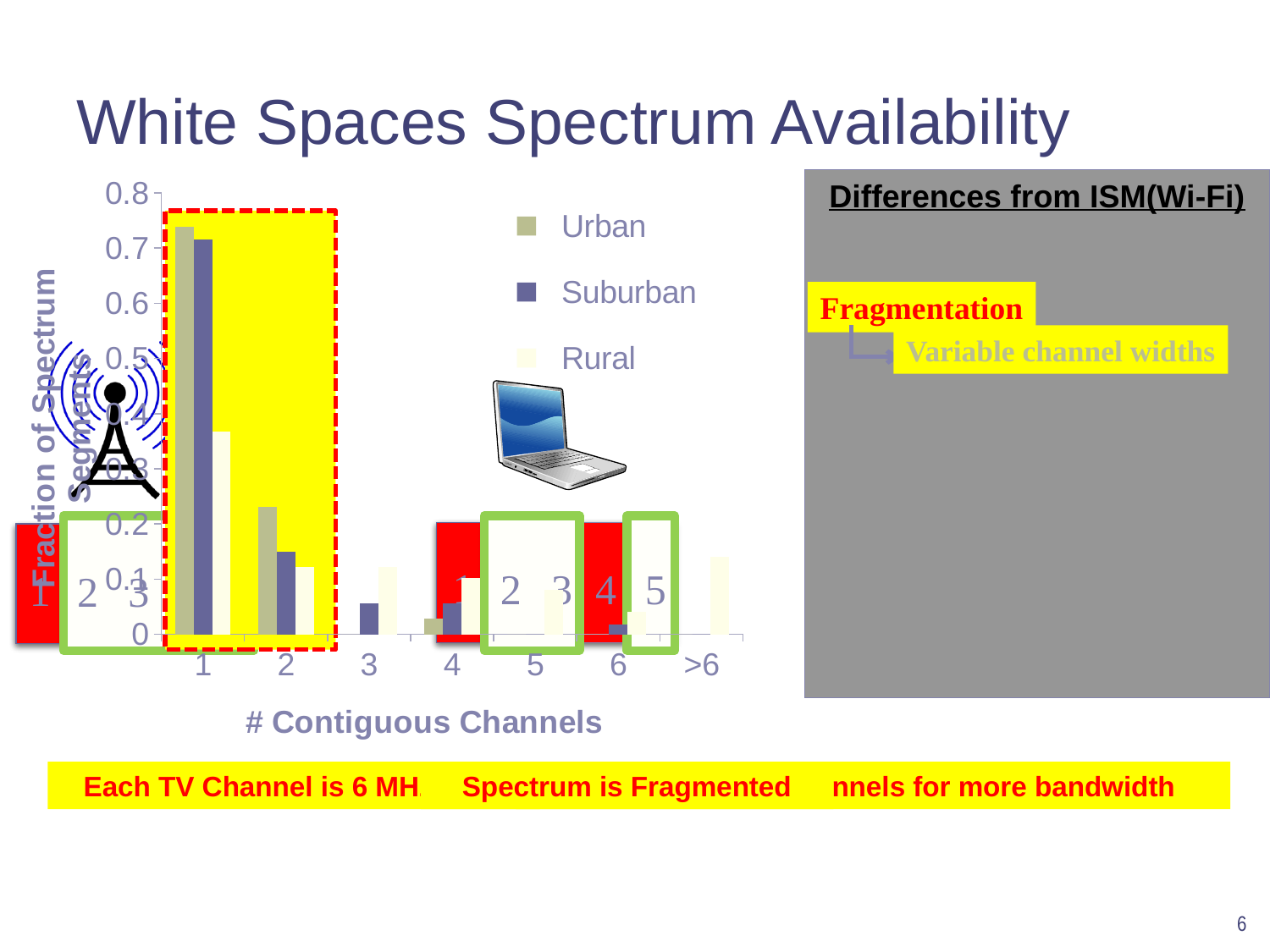
Is the Urban value for 2 contiguous channels greater or less than 0.3? less For which number of contiguous channels is the Rural value highest? 1 For 3 contiguous channels, which is larger: the Rural value or the Suburban value? Rural How many series does the chart's legend list? 3 Is the Rural value for 1 contiguous channel greater or less than 0.5? less How many categories are shown along the x axis of the chart? 7 Is the Urban value for 1 contiguous channel greater or less than 0.7? greater For 1 contiguous channel, which is larger: the Urban value or the Rural value? Urban What kind of chart is shown on the slide? bar chart For which number of contiguous channels is the Urban value highest? 1 What is the title of the chart's x axis? # Contiguous Channels